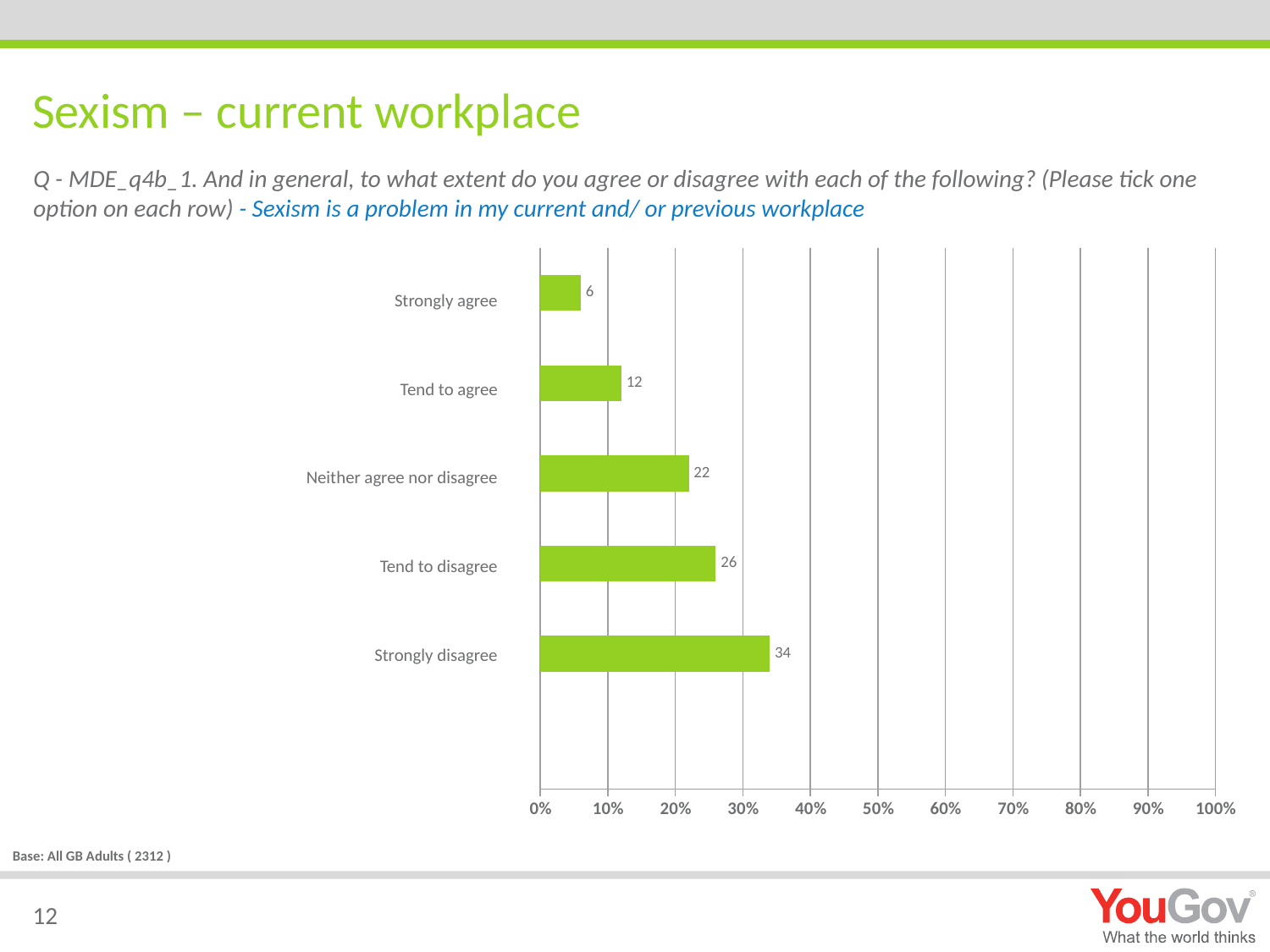
What is the value for Strongly disagree? 34 What is the value for Tend to agree? 12 What kind of chart is shown on the slide? bar chart Is the value for Strongly disagree greater or less than 30%? greater Which is larger, the value for Tend to disagree or the value for Tend to agree? Tend to disagree How many categories are shown in the chart? 5 What is the difference between the values for Strongly disagree and Strongly agree? 28 Which category has the lowest value? Strongly agree Which category has the highest value? Strongly disagree What is the difference between the values for Tend to disagree and Neither agree nor disagree? 4 What is the highest value shown on the x axis? 100% What is the value for Neither agree nor disagree? 22